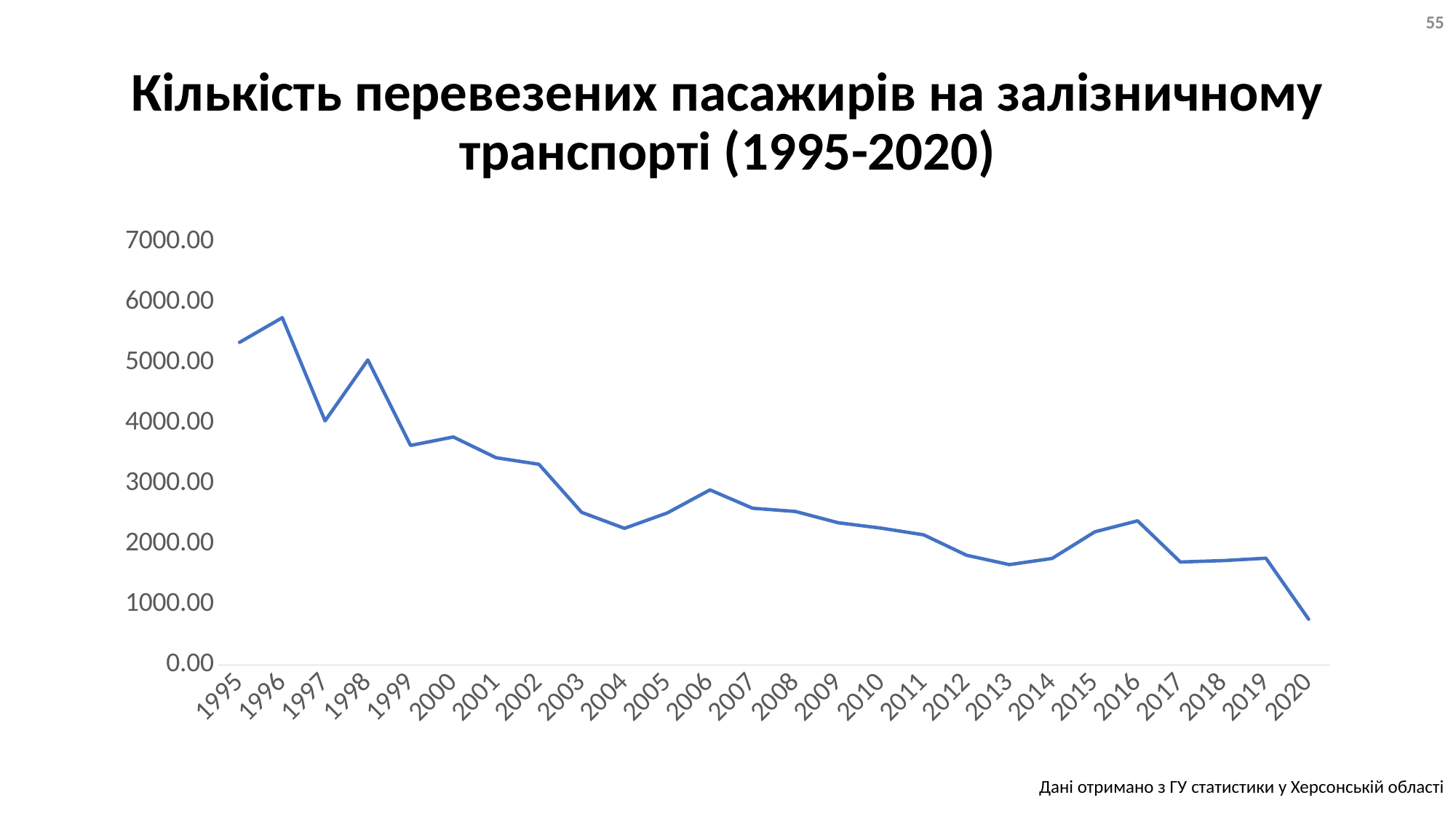
Is the value for 1997 greater or less than 5000.00? less Which is larger, the value for 2016 or the value for 2017? 2016 How many years are plotted along the x axis? 26 Which year has the highest value? 1996 Which is larger, the value for 1998 or the value for 1999? 1998 What is the title of the chart on the slide? Кількість перевезених пасажирів на залізничному транспорті (1995-2020) What kind of chart is shown on the slide? line chart Overall, do the values rise or fall from 1995 to 2020? fall Is the value for 2013 greater or less than 2000.00? less Is the value for 2020 greater or less than 1000.00? less Which year has the lowest value? 2020